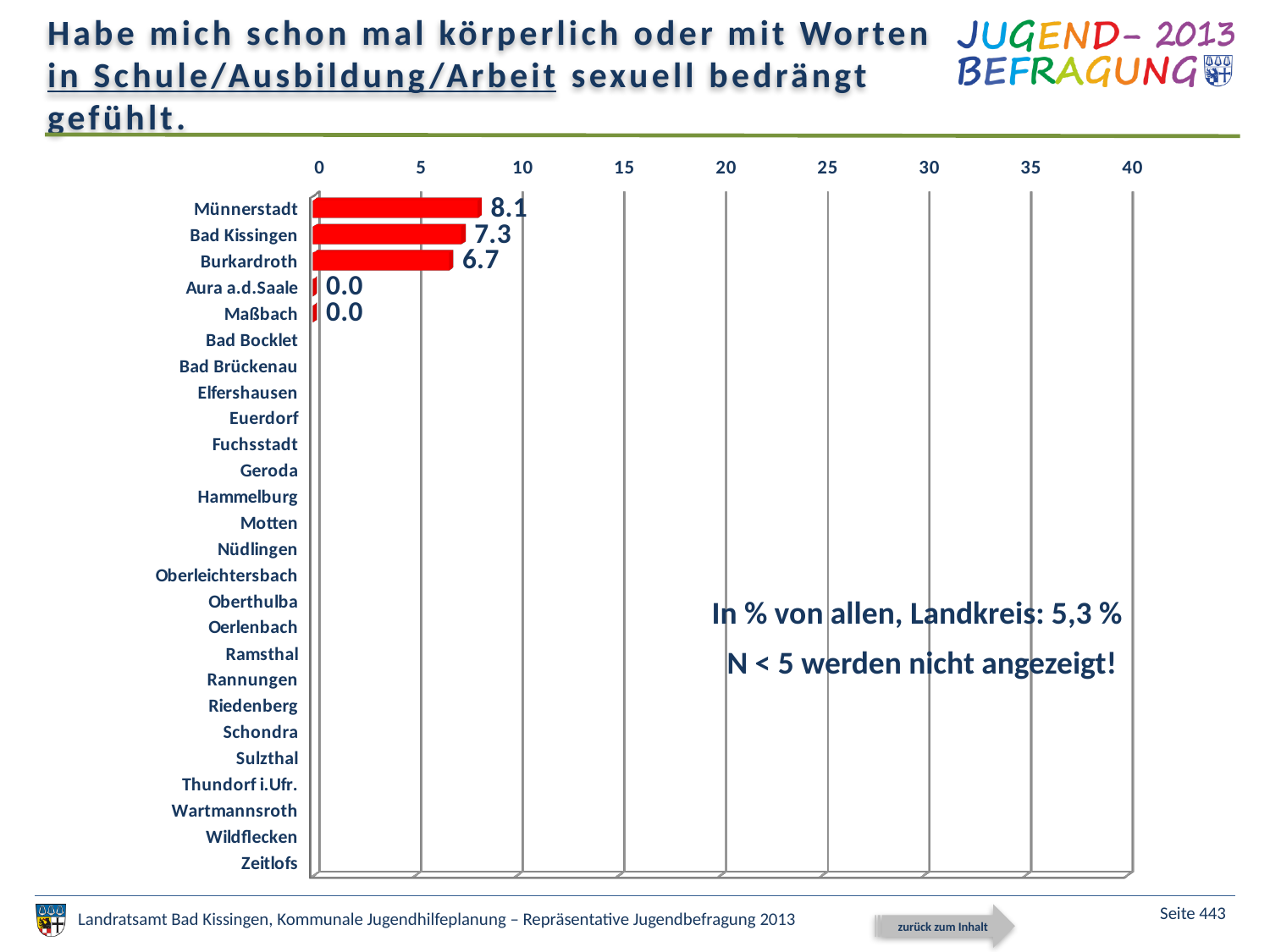
What is the value for Burkardroth? 6.7 How many categories have a data label displayed on the chart? 5 What kind of chart is shown on the slide? bar chart What is the difference between the values for Münnerstadt and Burkardroth? 1.4 What is the value for Bad Kissingen? 7.3 What is the value for Münnerstadt? 8.1 Which category has the highest value? Münnerstadt Which is larger, the value for Bad Kissingen or the value for Burkardroth? Bad Kissingen What is the Landkreis percentage stated in the text on the chart? 5,3 % What is the value for Aura a.d.Saale? 0.0 What is the difference between the values for Bad Kissingen and Burkardroth? 0.6 Is the value for Münnerstadt greater or less than 10? less